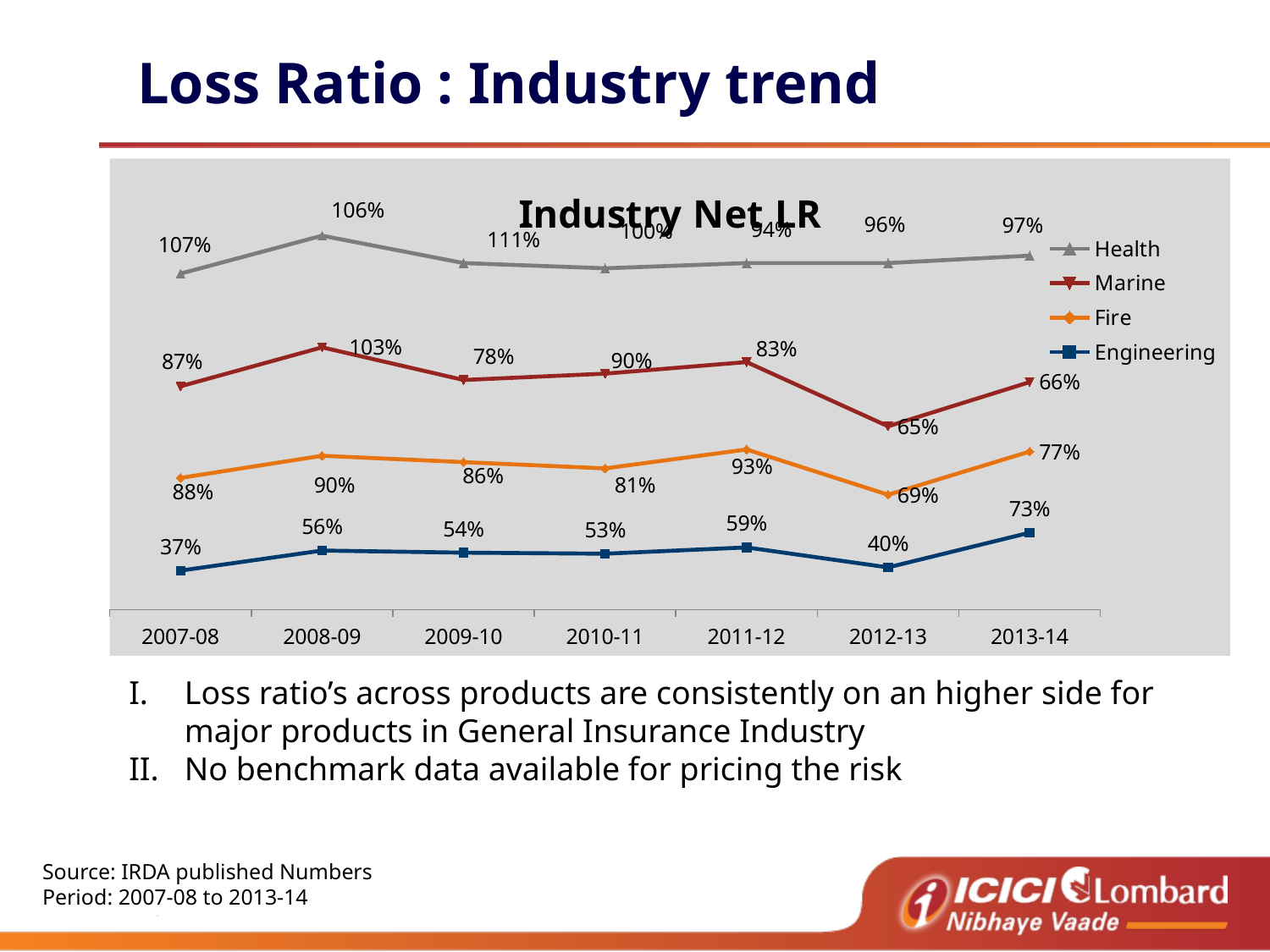
How many series does the legend of the chart list? 4 How many periods are shown along the x axis of the chart? 7 What is the Health loss ratio for 2013-14? 97% What is the Marine loss ratio for 2008-09? 103% What is the Fire loss ratio for 2013-14? 77% In which period is the Engineering loss ratio highest? 2013-14 What is the title of the chart? Industry Net LR By how many percentage points did the Engineering loss ratio change from 2012-13 to 2013-14? 33 percentage points In which period is the Fire loss ratio lowest? 2012-13 What is the Engineering loss ratio for 2007-08? 37% What kind of chart is shown on the slide? Line chart Which series has the highest loss ratio in 2007-08? Health